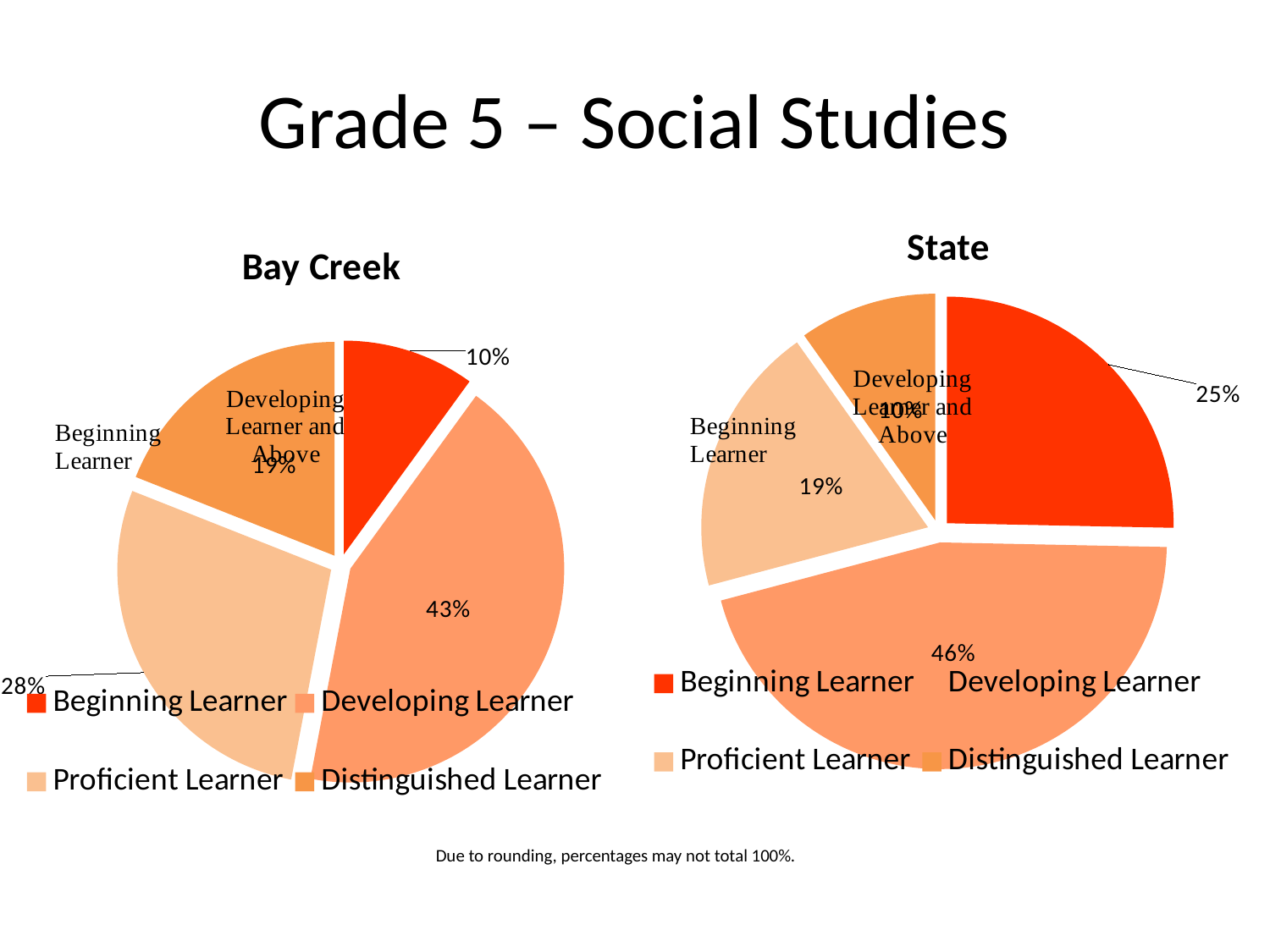
What is the difference between the Developing Learner percentage in the State chart and in the Bay Creek chart? 3% In the Bay Creek chart, what is the difference between the Proficient Learner and Distinguished Learner percentages? 9% In the State chart, what percentage is shown for Distinguished Learner? 10% Which chart shows a larger Beginning Learner percentage, Bay Creek or State? State In the State chart, which category has the smallest slice? Distinguished Learner What colour represents Beginning Learner in the legend? Red What type of chart is the Bay Creek chart? Pie chart In the State chart, what percentage is shown for Beginning Learner? 25% In the Bay Creek chart, what percentage is shown for Developing Learner? 43% In the Bay Creek chart, which category has the largest slice? Developing Learner In the Bay Creek chart, what percentage is shown for Beginning Learner? 10% How many slices does the State pie chart have? 4